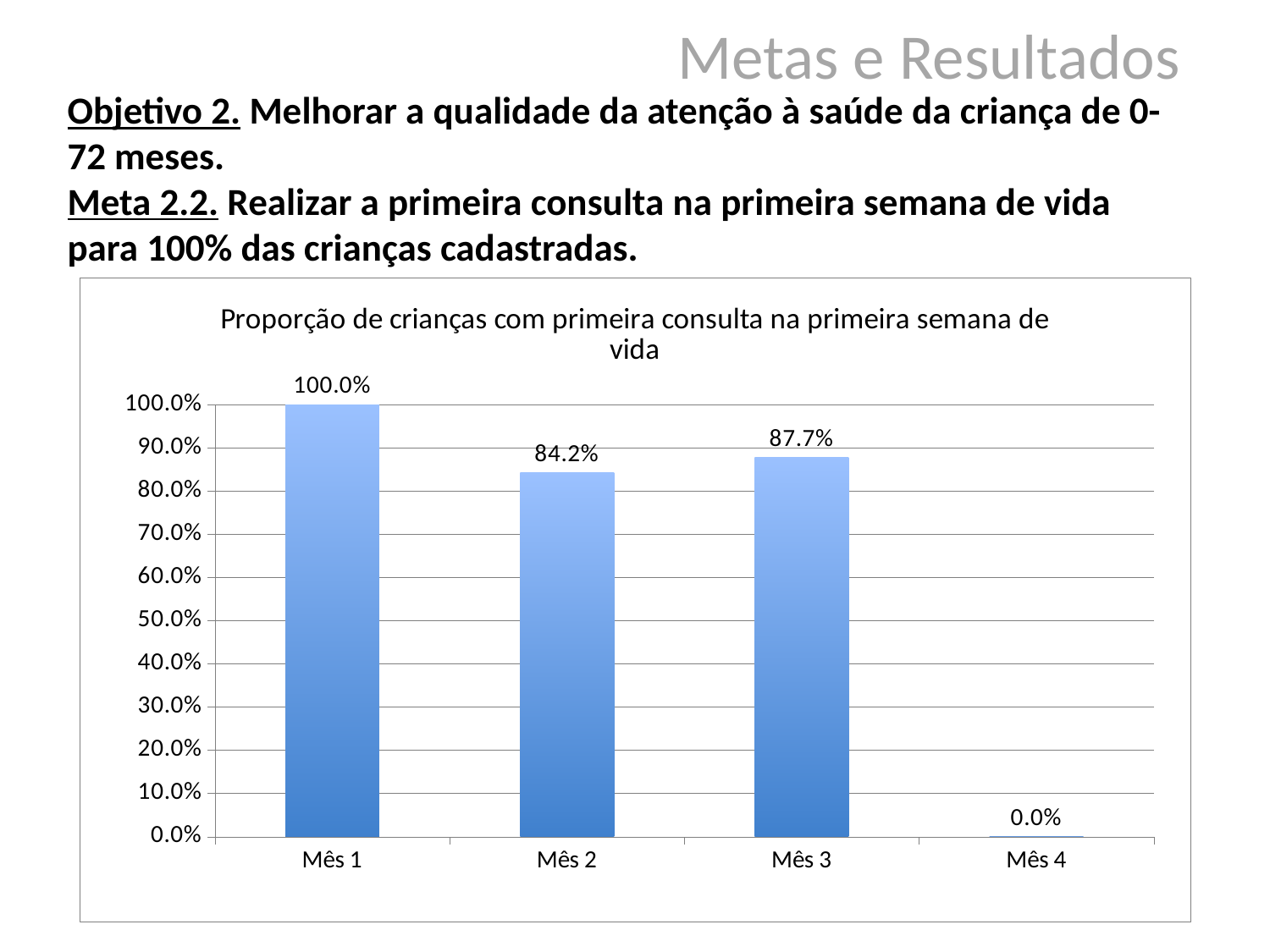
Which month has the highest value? Mês 1 What kind of chart is shown on the slide? bar chart What is the title of the chart? Proporção de crianças com primeira consulta na primeira semana de vida What is the value for Mês 2? 84.2% Which is larger, the value for Mês 2 or the value for Mês 3? Mês 3 What is the value for Mês 1? 100.0% What is the value for Mês 4? 0.0% What is the value for Mês 3? 87.7% Which month has the lowest value? Mês 4 What is the difference between the values for Mês 3 and Mês 2? 3.5% How many months are shown on the x axis? 4 Is the value for Mês 2 greater or less than 90.0%? less